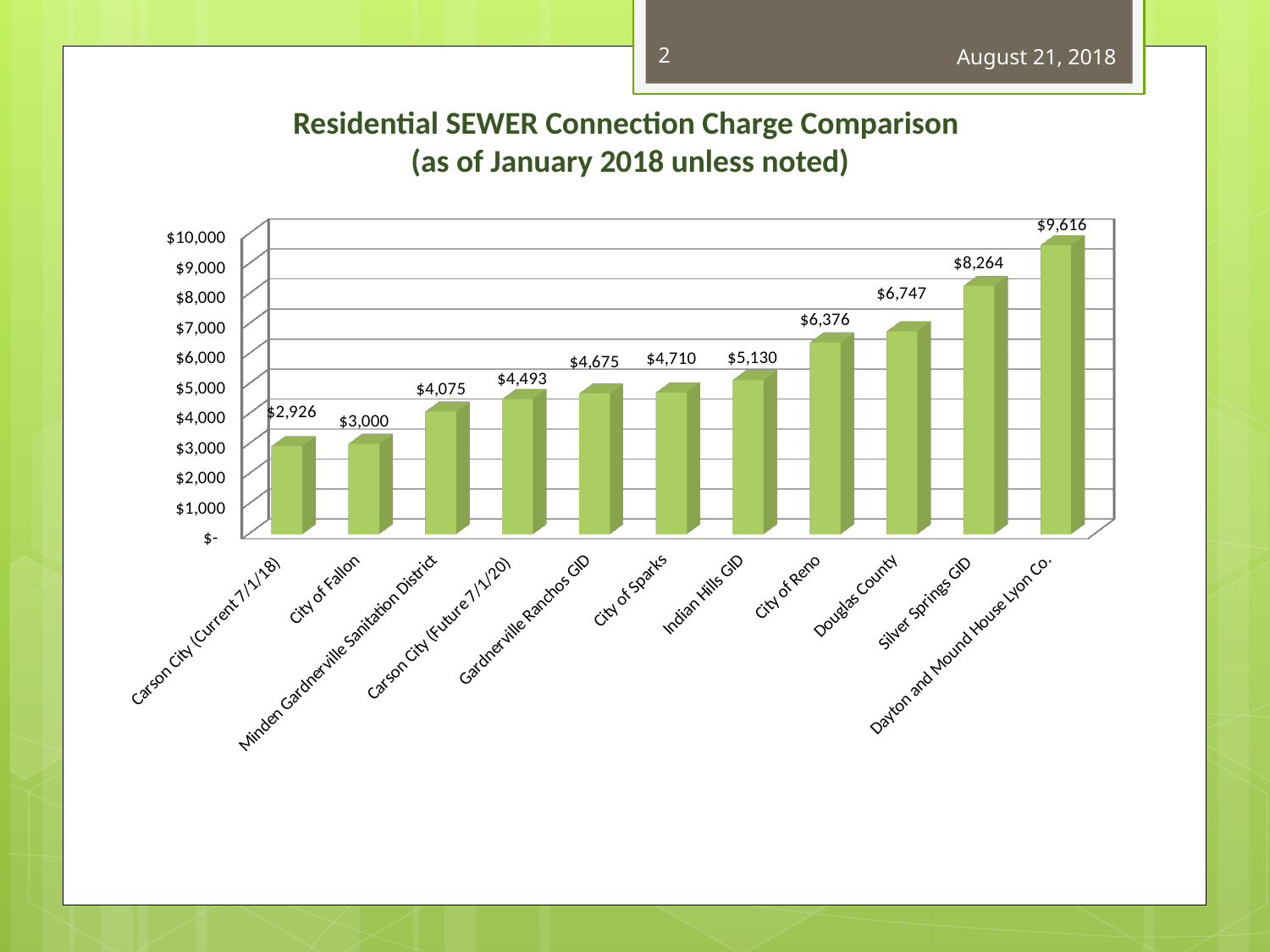
What is the residential sewer connection charge for Carson City (Current 7/1/18)? $2,926 What is the residential sewer connection charge for City of Reno? $6,376 What kind of chart is shown on the slide? bar chart What is the difference between the Douglas County charge and the City of Reno charge? $371 Which has a higher connection charge, Indian Hills GID or City of Sparks? Indian Hills GID Which entity has the highest residential sewer connection charge? Dayton and Mound House Lyon Co. Do the connection charges rise or fall from left to right across the chart? rise Is the value for Minden Gardnerville Sanitation District greater or less than $5,000? less How many entities are compared in the chart? 11 What is the difference between the Carson City (Future 7/1/20) charge and the Carson City (Current 7/1/18) charge? $1,567 Which entity has the lowest residential sewer connection charge? Carson City (Current 7/1/18) What is the residential sewer connection charge for Silver Springs GID? $8,264